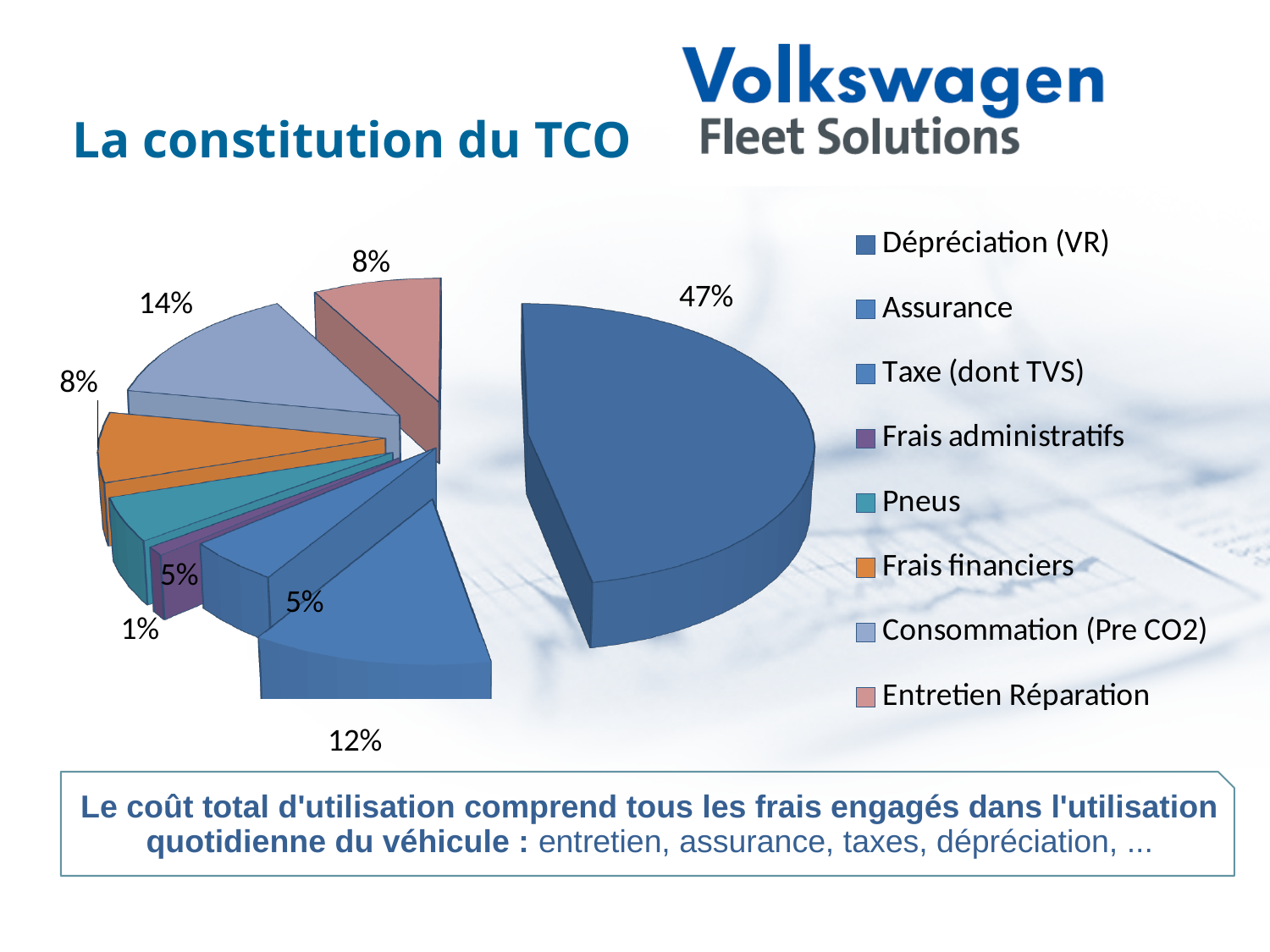
What is the smallest percentage labelled on the pie chart? 1% How many slices does the pie chart have? 8 What percentage is shown for Dépréciation (VR)? 47% What percentage is shown for Consommation (Pre CO2)? 14% Which is larger, the share for Assurance or the share for Consommation (Pre CO2)? Consommation (Pre CO2) What is the title of the slide containing the chart? La constitution du TCO What percentage is shown for Entretien Réparation? 8% What kind of chart is shown on the slide? pie chart What percentage is shown for Frais financiers? 8% Which category has the largest share of the pie? Dépréciation (VR) By how many percentage points does Dépréciation (VR) exceed Assurance? 35 What percentage is shown for Assurance? 12%